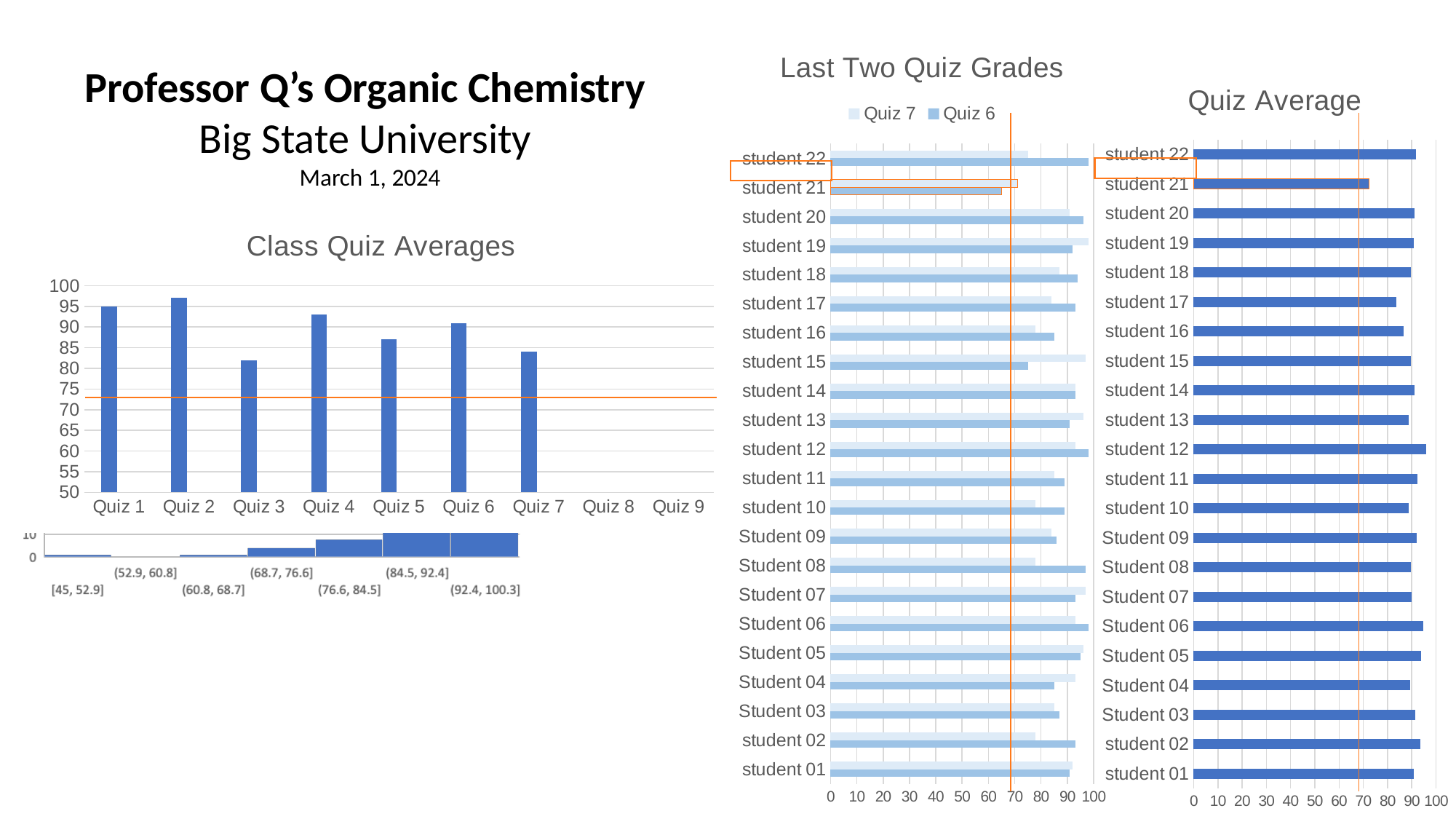
In the 'Quiz Average' chart, which student has the lowest average? student 21 In the 'Class Quiz Averages' chart, is the value for Quiz 3 greater or less than 85? less In the 'Class Quiz Averages' chart, which quiz has the highest average? Quiz 2 In the 'Class Quiz Averages' chart, how many quizzes have a bar plotted? 7 In the 'Last Two Quiz Grades' chart, is the Quiz 6 value for student 21 greater or less than 70? less In the 'Quiz Average' chart, is the value for student 21 greater or less than 80? less What kind of chart is the 'Class Quiz Averages' chart? bar chart How many students are shown in the 'Last Two Quiz Grades' chart? 22 How many series does the legend of the 'Last Two Quiz Grades' chart list? 2 What are the legend entries in the 'Last Two Quiz Grades' chart? Quiz 7 and Quiz 6 In the 'Class Quiz Averages' chart, which is larger, the value for Quiz 5 or the value for Quiz 6? Quiz 6